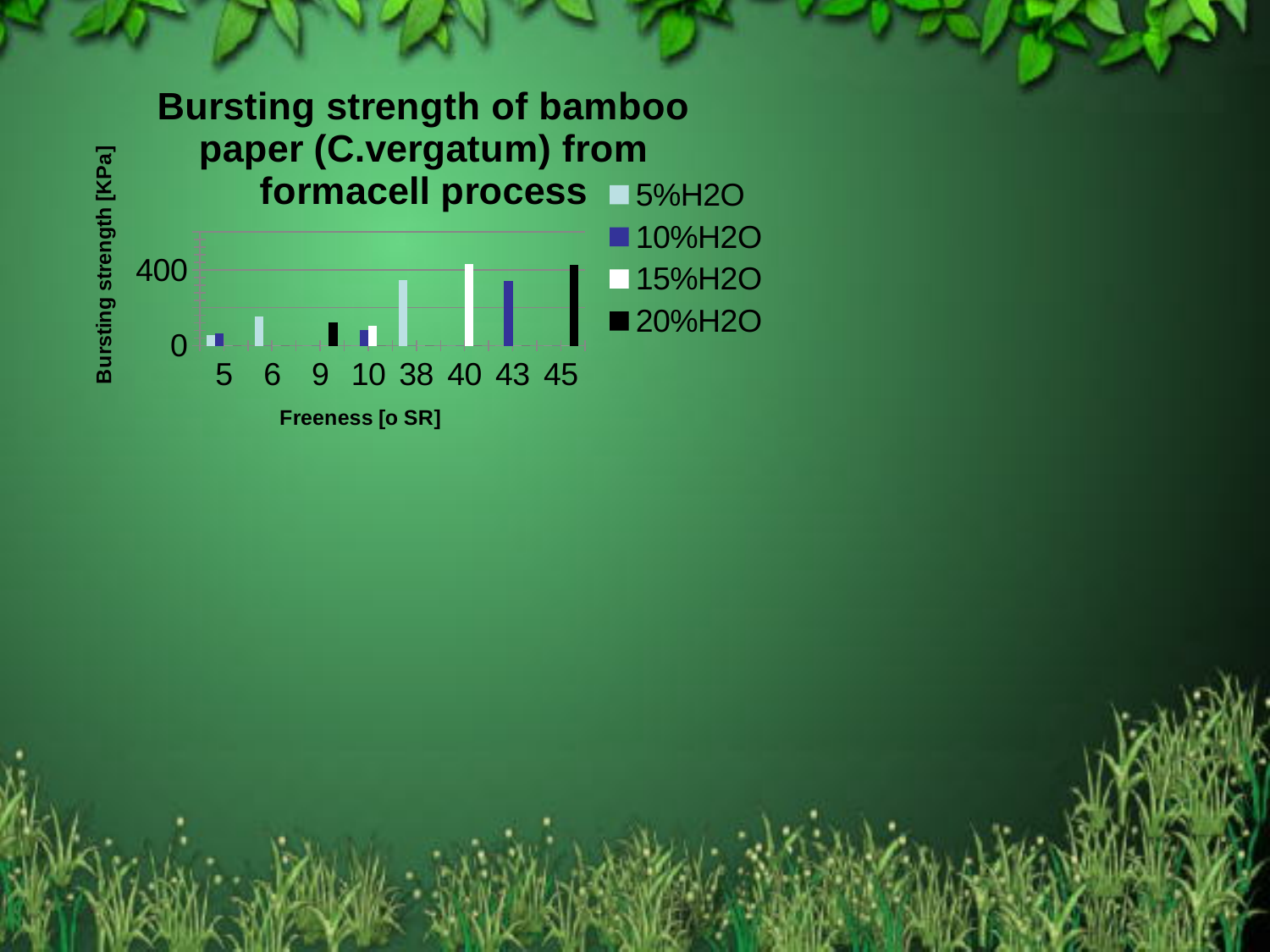
How many freeness categories are shown on the x axis of the chart? 8 Is the bursting strength value at freeness 9 greater or less than 400? less Which series is shown at freeness 45? 20%H2O What is the title of the chart? Bursting strength of bamboo paper (C.vergatum) from formacell process How many series does the chart's legend list? 4 Which is larger: the bar at freeness 40 or the bar at freeness 5? 40 Which is larger: the 10%H2O bar at freeness 43 or the 10%H2O bar at freeness 10? 43 Which is larger: the bar at freeness 38 or the bar at freeness 6? 38 What kind of chart is shown on the slide? bar chart What is the label of the x axis of the chart? Freeness [o SR] Is the bursting strength value at freeness 6 greater or less than 400? less